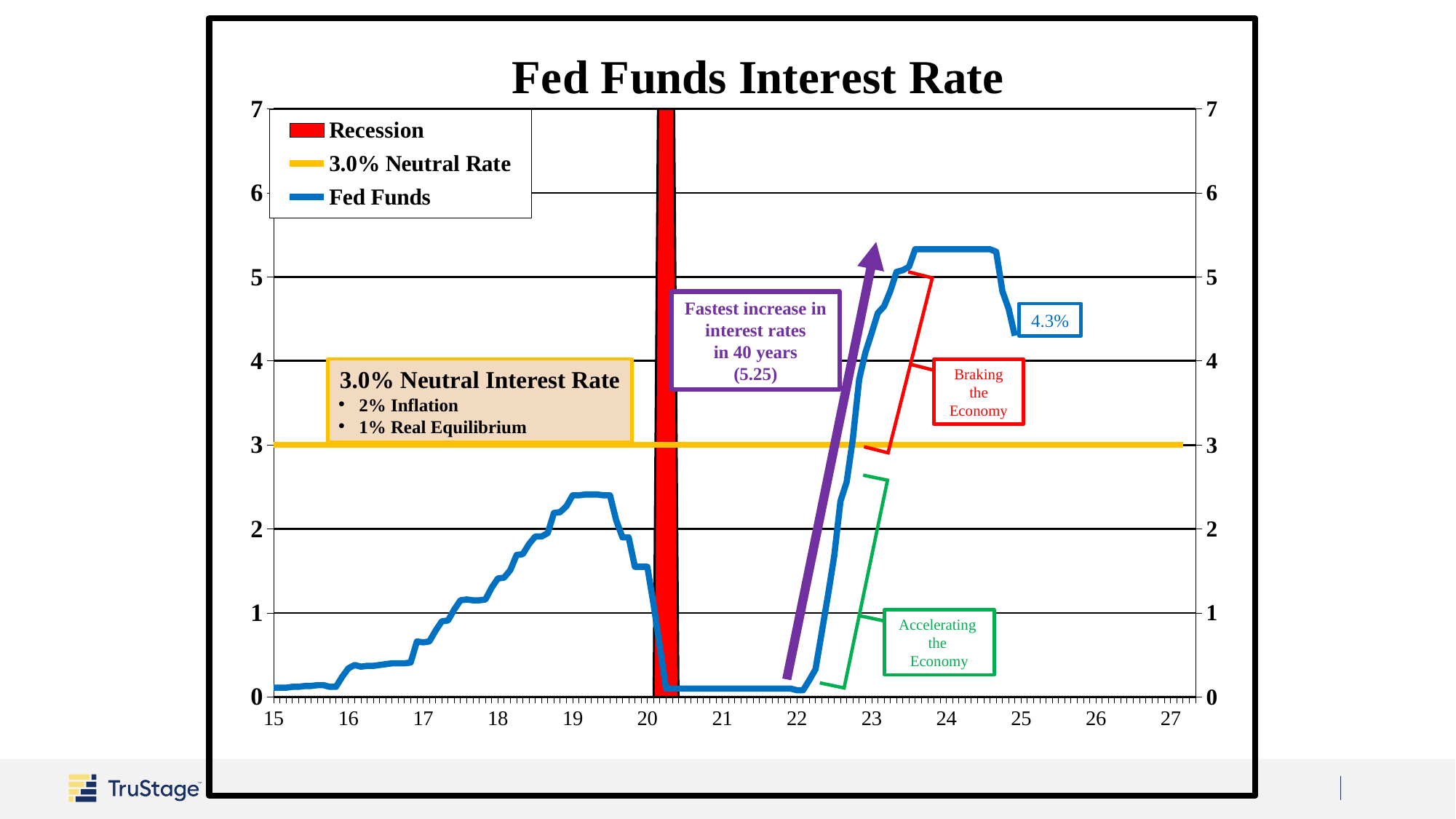
Is the Fed Funds rate in 2021 greater or less than 1? less What does the red vertical bar around 2020 represent, according to the legend? Recession How many entries does the legend list? 3 Does the Fed Funds rate rise or fall between 2022 and 2023? rise What value does the yellow neutral rate line sit at? 3.0% What kind of chart is used to show the Fed Funds series? line chart Which is higher, the Fed Funds rate in 2024 or in 2019? 2024 According to the annotation, what level did the fastest increase in interest rates in 40 years reach? 5.25 What is the title of the chart? Fed Funds Interest Rate What is the labeled Fed Funds rate at the end of the line, around 2025? 4.3% Is the Fed Funds rate in 2024 greater or less than 5? greater Is the Fed Funds rate in 2019 greater or less than 3? less